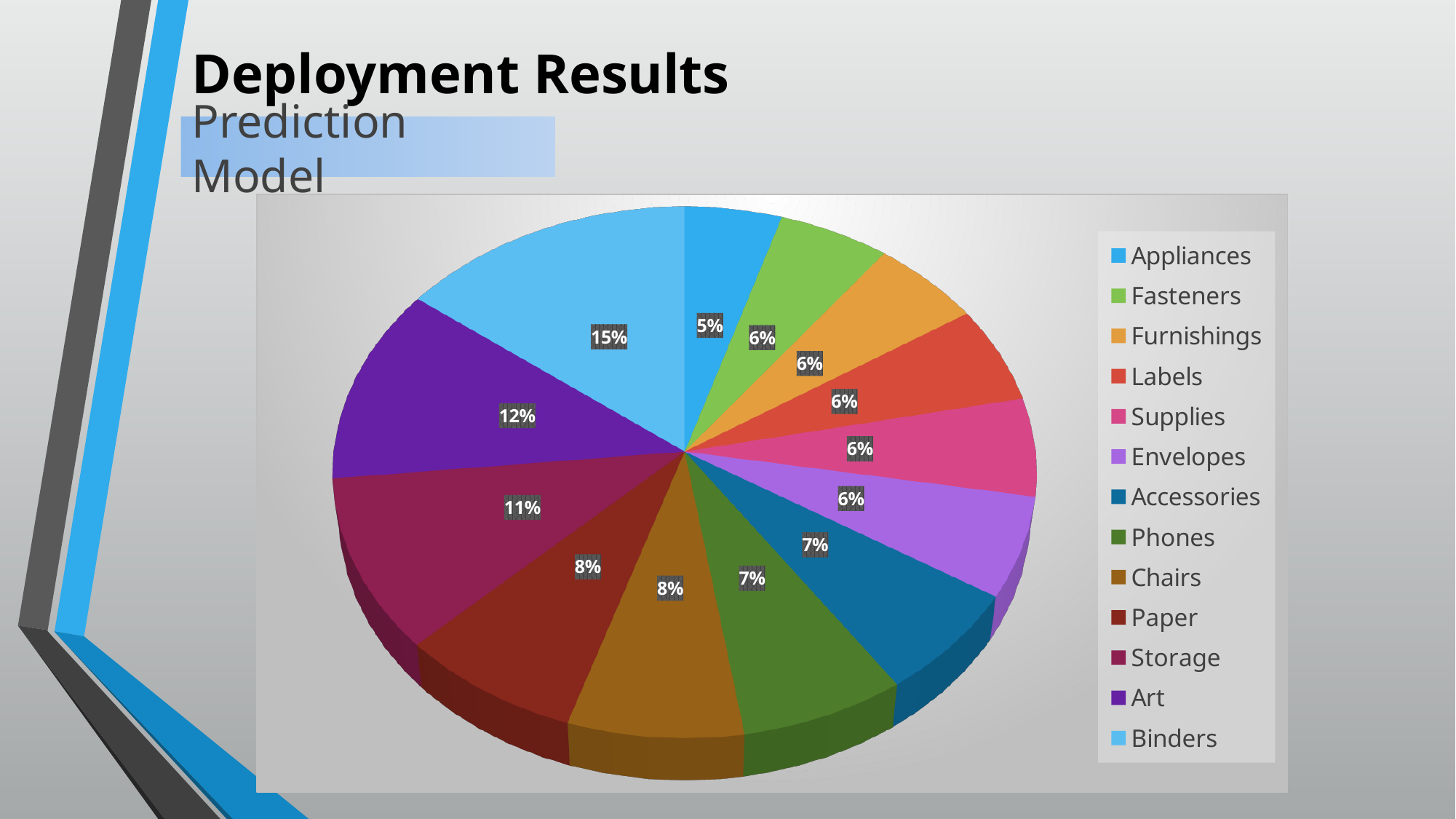
What share of the pie does Binders have? 15% What kind of chart is shown on the slide? pie chart What share of the pie does Appliances have? 5% Which category has the largest slice of the pie? Binders What share of the pie does Storage have? 11% How many categories does the pie chart's legend list? 13 Which category is listed first in the legend? Appliances What share of the pie does Chairs have? 8% What share of the pie does Art have? 12% Which category has the smallest slice of the pie? Appliances Which slice is larger, Storage or Paper? Storage What is the difference in percentage points between the Binders slice and the Art slice? 3